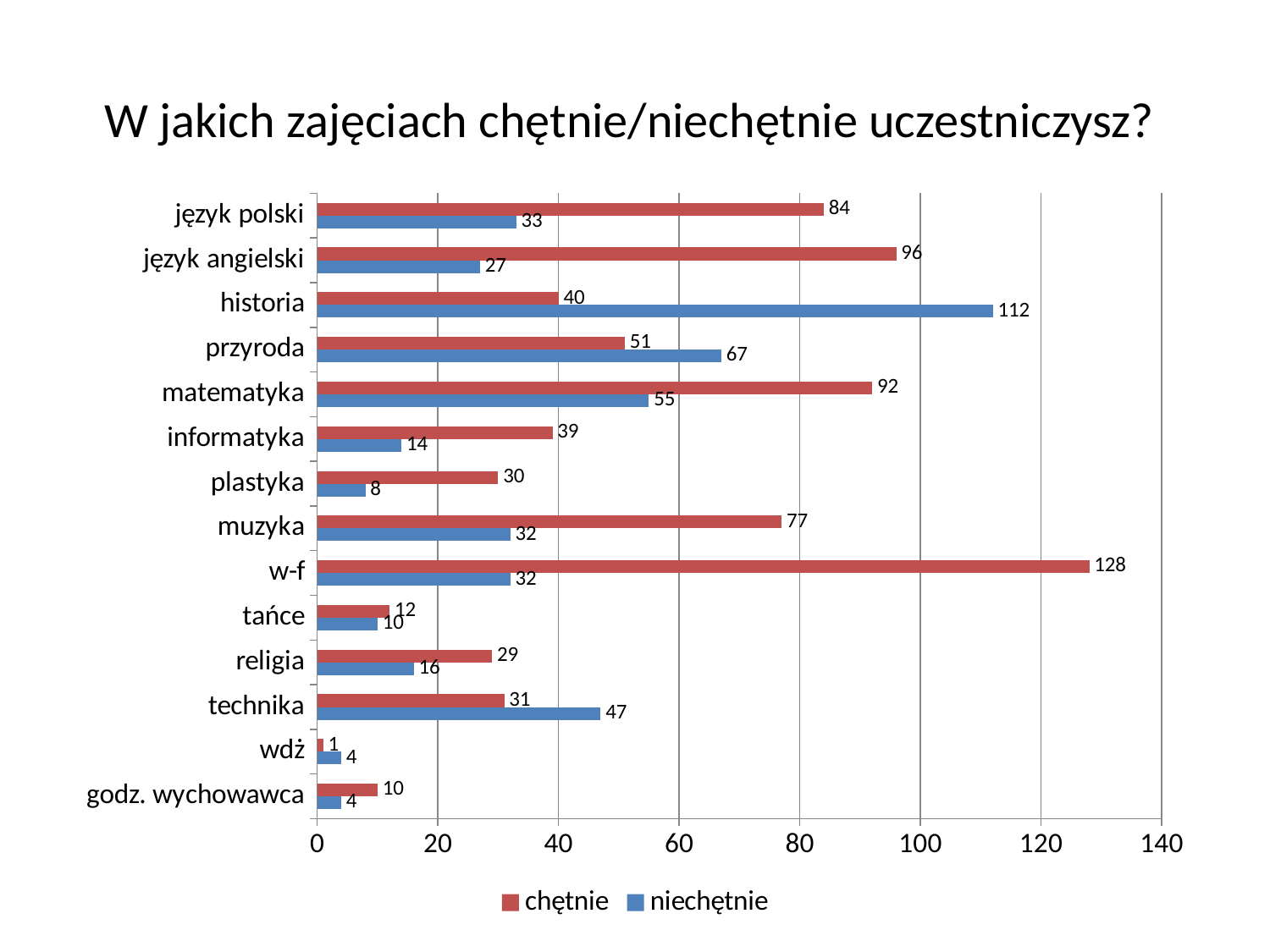
What is the 'niechętnie' value for technika? 47 For przyroda, which is larger: the 'chętnie' value or the 'niechętnie' value? niechętnie Which category has the lowest 'chętnie' value? wdż What type of chart is shown on the slide? bar chart What is the 'niechętnie' value for historia? 112 What is the difference between the 'chętnie' and 'niechętnie' values for język angielski? 69 Which category has the highest 'niechętnie' value? historia How many categories are shown on the chart? 14 What is the 'chętnie' value for w-f? 128 Which category has the highest 'chętnie' value? w-f What is the 'chętnie' value for matematyka? 92 How many series does the legend list? 2